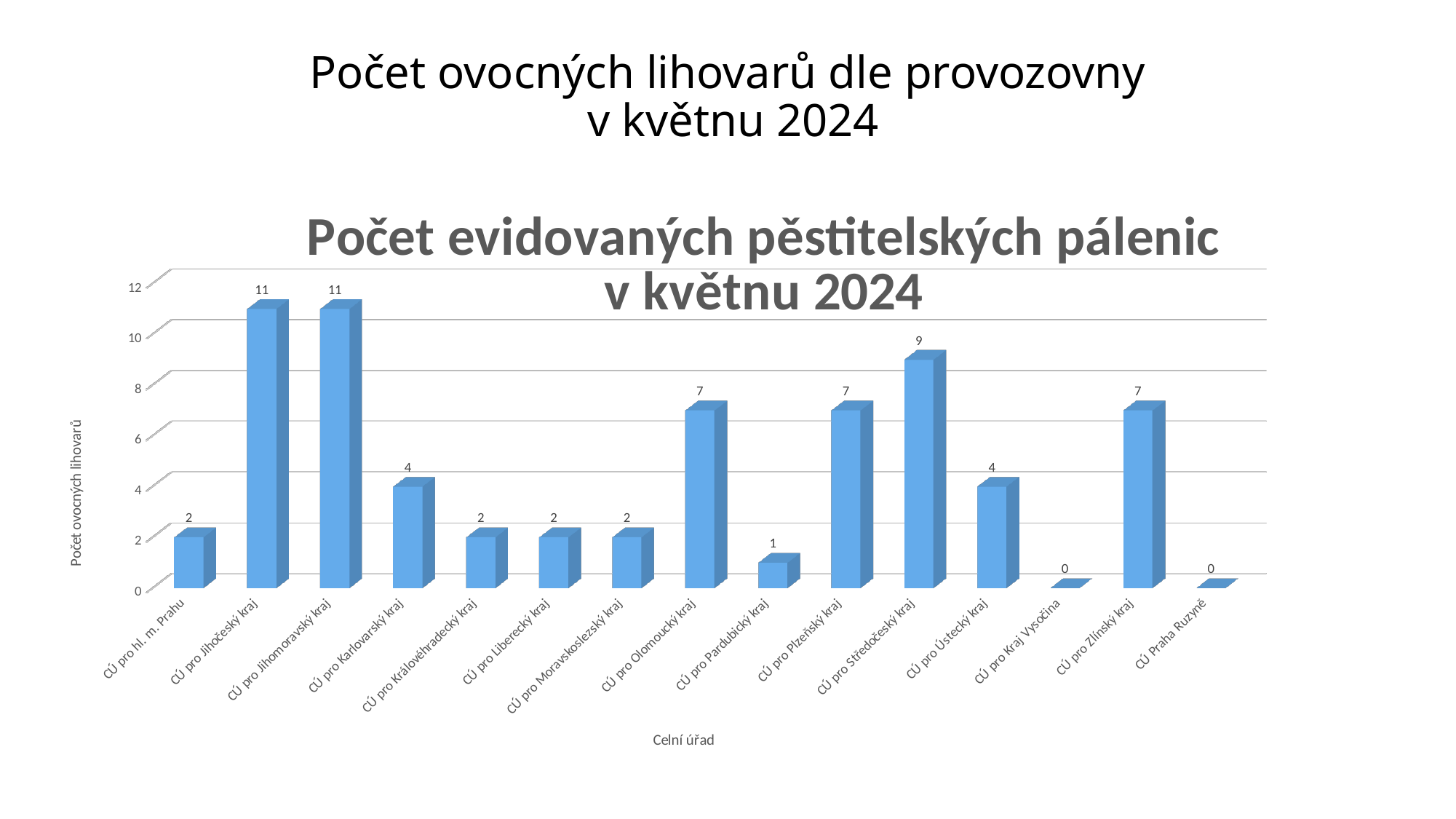
What is the value for CÚ pro Středočeský kraj? 9 Which is larger, the value for CÚ pro Olomoucký kraj or the value for CÚ pro Ústecký kraj? CÚ pro Olomoucký kraj What is the value for CÚ pro Karlovarský kraj? 4 What is the label of the vertical axis? Počet ovocných lihovarů Which two categories share the highest value on the chart? CÚ pro Jihočeský kraj and CÚ pro Jihomoravský kraj Which two categories have a value of 0? CÚ pro Kraj Vysočina and CÚ Praha Ruzyně What is the difference between the values for CÚ pro Jihočeský kraj and CÚ pro Středočeský kraj? 2 What kind of chart is shown on the slide? Bar chart What is the title of the chart? Počet evidovaných pěstitelských pálenic v květnu 2024 How many categories are shown on the x axis? 15 What is the value for CÚ pro Pardubický kraj? 1 What is the value for CÚ pro Zlínský kraj? 7